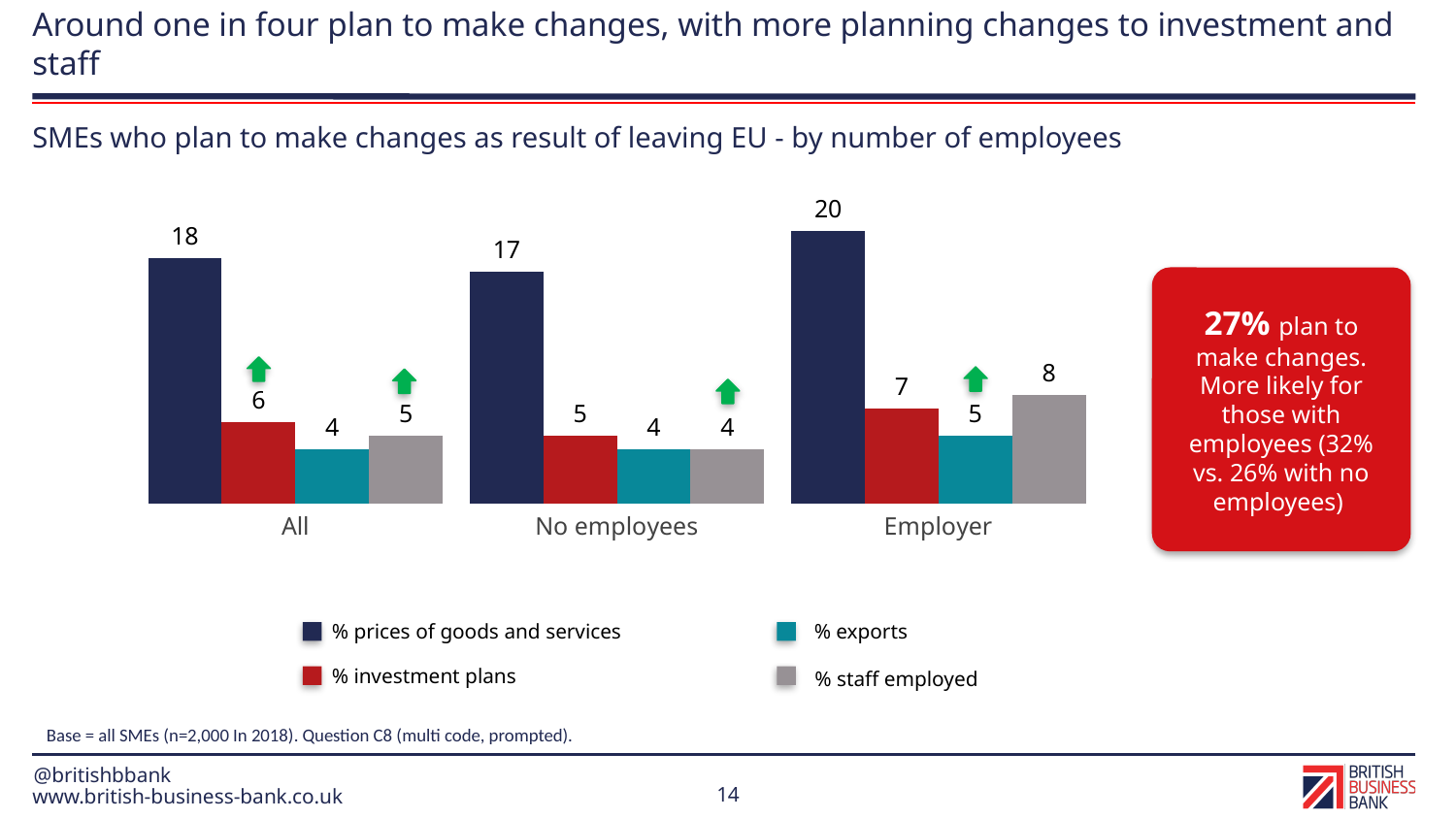
What is the value for % staff employed in the Employer group? 8 Which group has the highest value for % prices of goods and services? Employer What is the difference between % prices of goods and services for Employer and for No employees? 3 Which series has the lowest value in the Employer group? % exports How many series does the legend list? 4 What is the value for % investment plans in the No employees group? 5 Which is larger: % investment plans for Employer or % investment plans for All? Employer What kind of chart is shown on the slide? Bar chart What is the difference between % staff employed for Employer and for No employees? 4 What is the value for % prices of goods and services in the All group? 18 Which legend entry is shown in dark navy blue? % prices of goods and services How many employee groups are shown on the x axis? 3